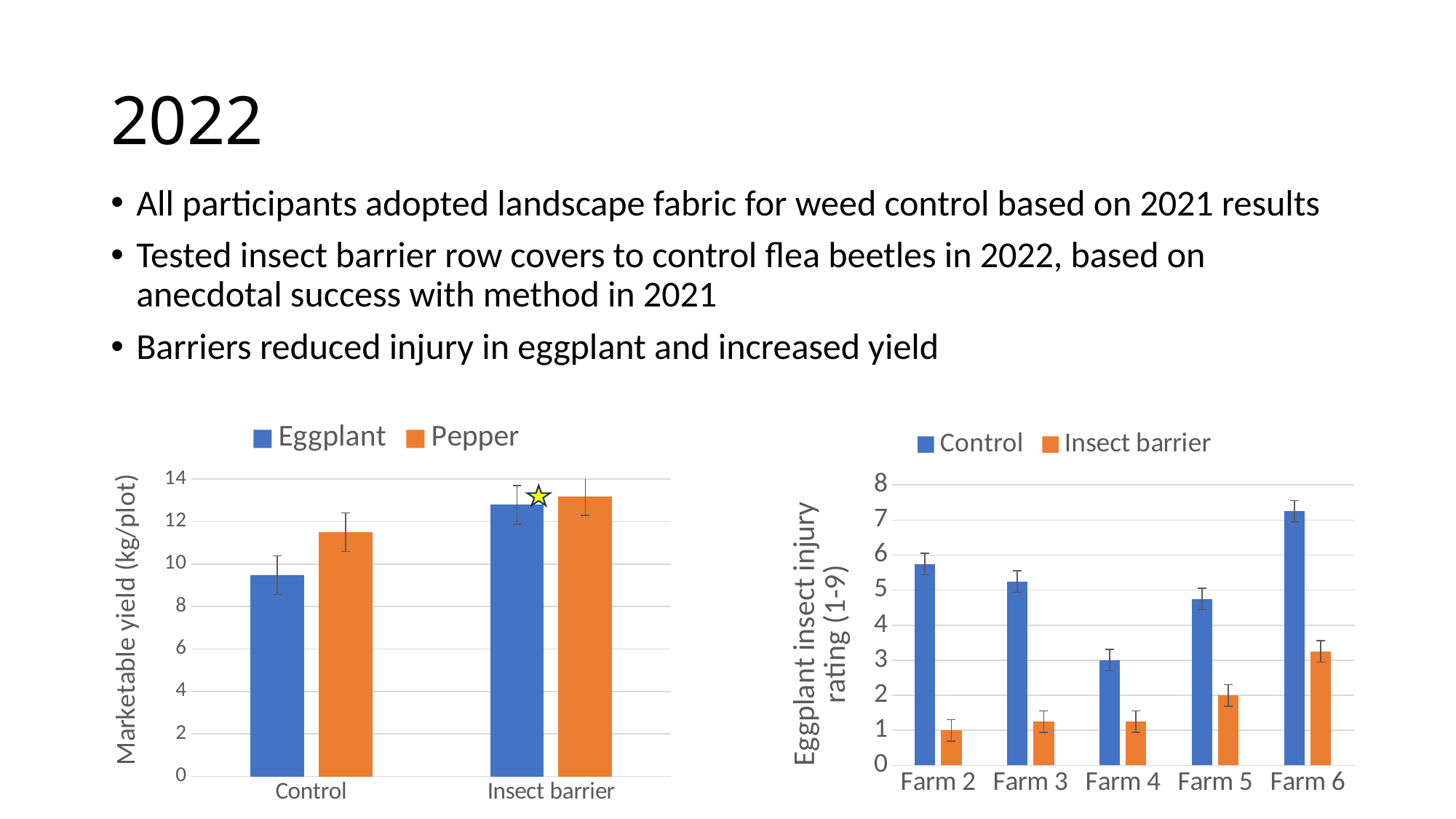
In the left chart (Marketable yield), which is larger for Eggplant: Control or Insect barrier? Insect barrier In the right chart (Eggplant insect injury rating), which farm has the highest Control value? Farm 6 In the right chart (Eggplant insect injury rating), which is larger for Farm 2: Control or Insect barrier? Control What kind of chart is the left chart showing marketable yield? bar chart In the right chart (Eggplant insect injury rating), is the Control value for Farm 6 greater or less than 6? greater In the left chart (Marketable yield), is the Eggplant value for Control greater or less than 8? greater In the right chart (Eggplant insect injury rating), is the Insect barrier value for Farm 6 greater or less than 2? greater In the right chart (Eggplant insect injury rating), which farm has the lowest Control value? Farm 4 How many farms are shown on the x axis of the right chart (Eggplant insect injury rating)? 5 How many series does the legend of the left chart (Marketable yield) list? 2